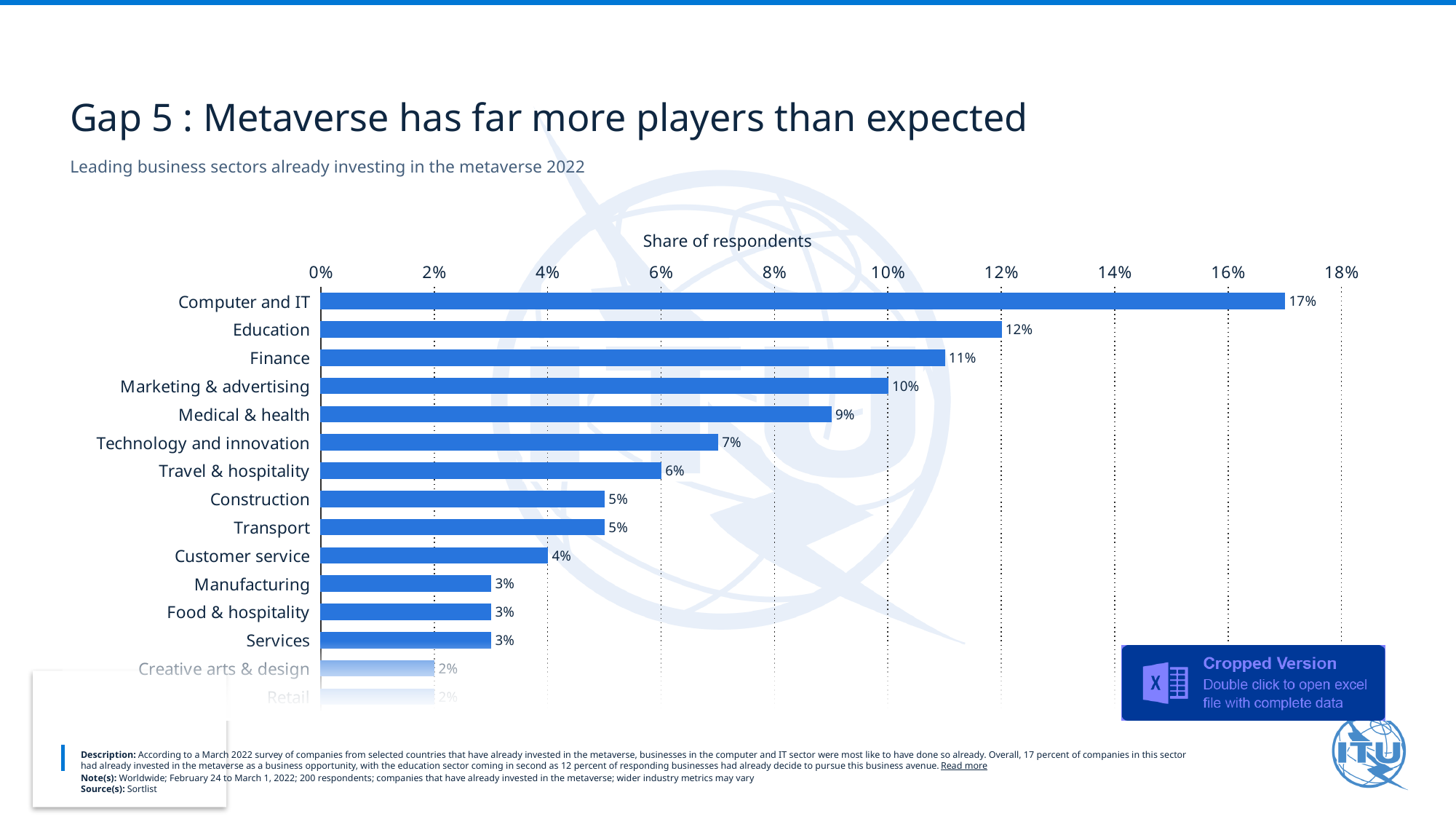
What is the difference in share of respondents between Finance and Travel & hospitality? 5% Which has a larger share of respondents, Marketing & advertising or Technology and innovation? Marketing & advertising Is the value for Finance greater or less than 10%? greater What is the share of respondents for Customer service? 4% What kind of chart is shown on the slide? Bar chart What is the share of respondents for Computer and IT? 17% Which business sector has the highest share of respondents? Computer and IT What is the difference in share of respondents between Computer and IT and Education? 5% What is the share of respondents for Education? 12% What is the subtitle describing the chart on the slide? Leading business sectors already investing in the metaverse 2022 What is the share of respondents for Medical & health? 9% What is the label of the horizontal axis of the chart? Share of respondents